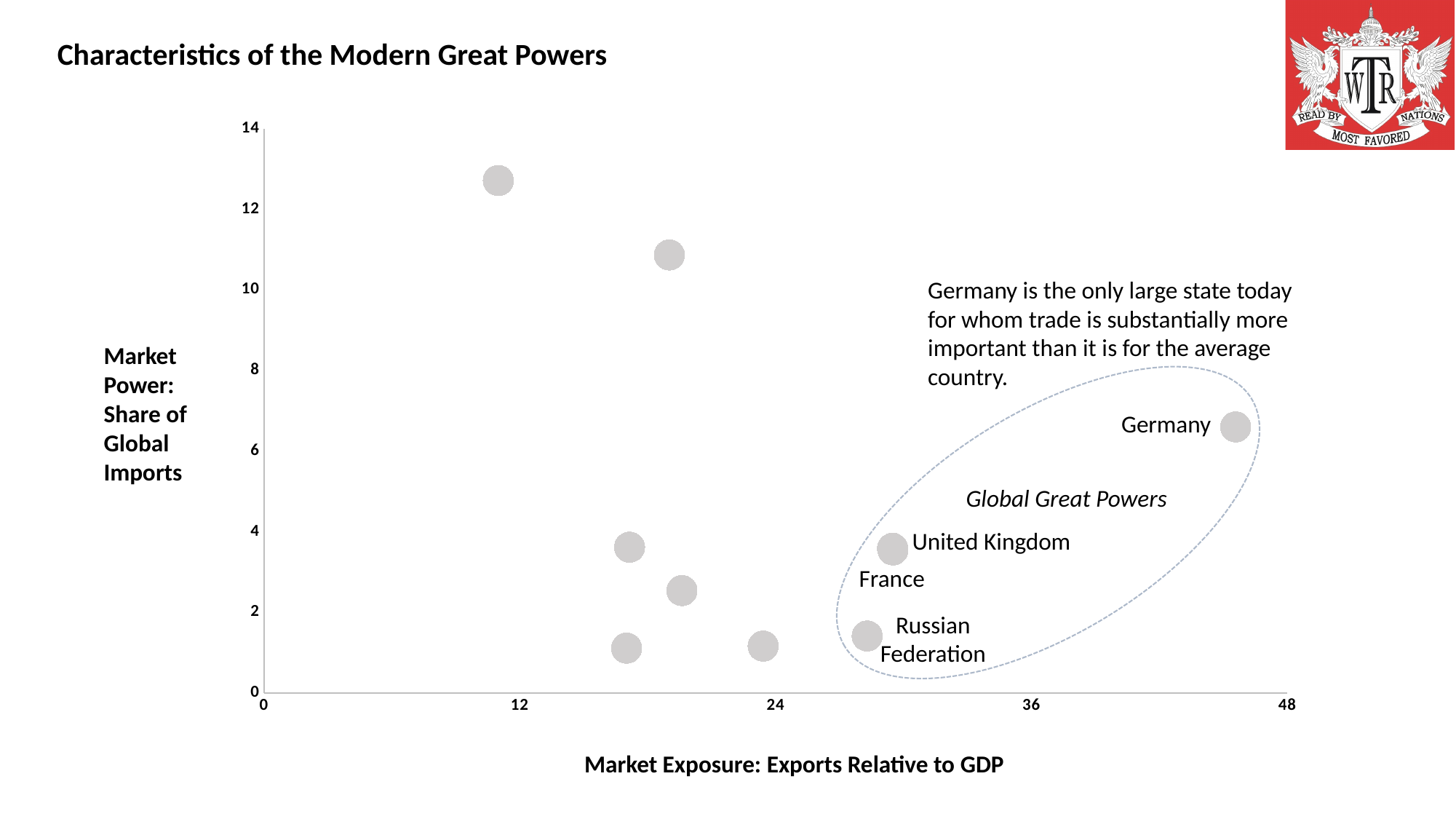
Is the Share of Global Imports (y-axis) value for Germany greater or less than 8? less Is the Share of Global Imports (y-axis) value for the Russian Federation greater or less than 2? less What is the title of the chart on the slide? Characteristics of the Modern Great Powers Is the Market Exposure (x-axis) value for Germany greater or less than 36? greater What kind of chart is shown on the slide? scatter chart What is the label of the horizontal axis? Market Exposure: Exports Relative to GDP Among the labelled countries, which has the highest Market Exposure (x-axis) value? Germany Among the labelled countries, which has the lowest Share of Global Imports (y-axis) value? Russian Federation Which has the higher Share of Global Imports (y-axis) value, Germany or the Russian Federation? Germany Which has the higher Market Exposure (x-axis) value, Germany or the United Kingdom? Germany